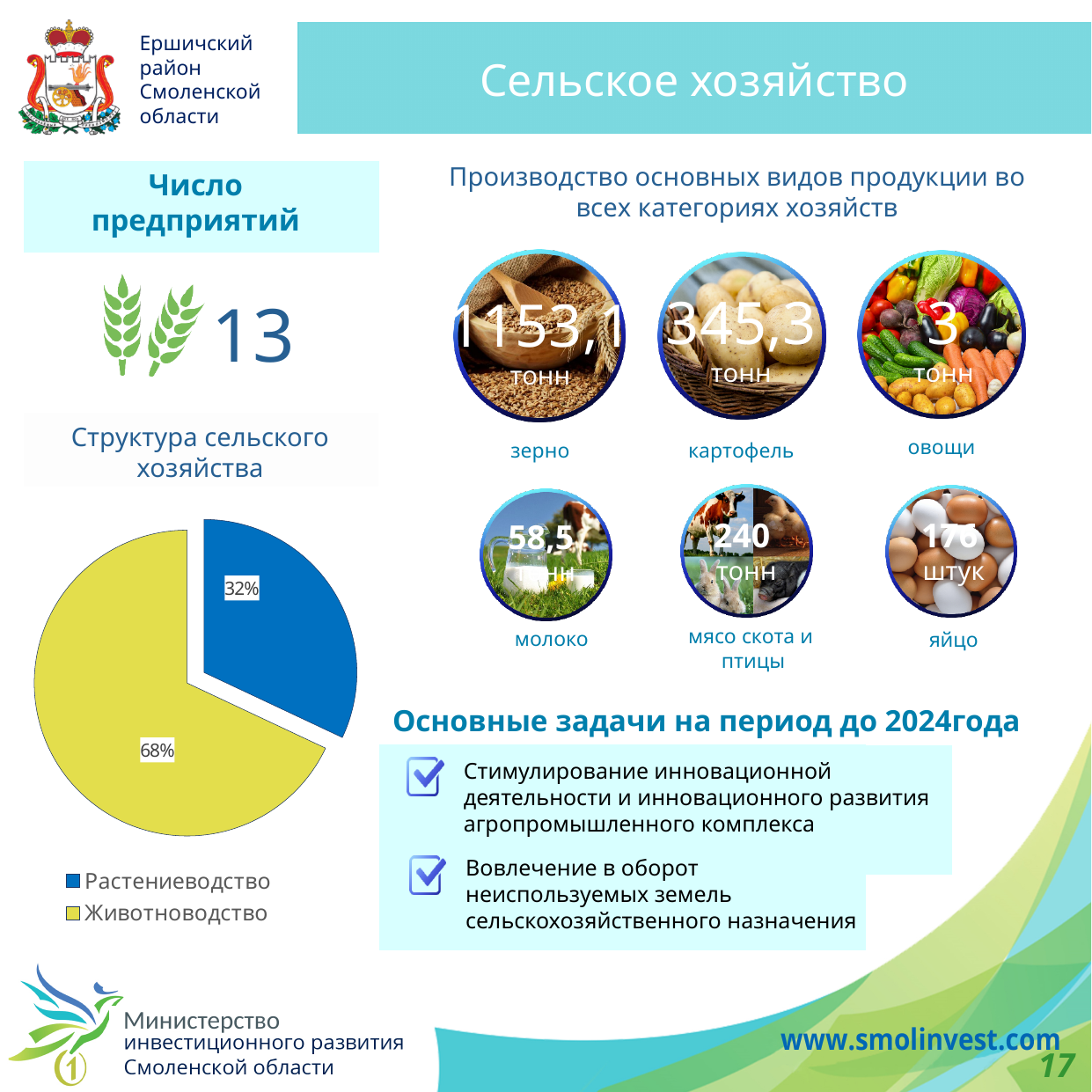
In the pie chart, what share does Животноводство have? 68% Is the share of Растениеводство in the pie chart greater or less than 50%? less What kind of chart is used to show the structure of agriculture (Структура сельского хозяйства)? pie chart Which category has the smallest slice in the pie chart? Растениеводство What colour is the Животноводство slice in the pie chart? yellow By how many percentage points does Животноводство exceed Растениеводство in the pie chart? 36 Which is larger in the pie chart, Растениеводство or Животноводство? Животноводство In the pie chart, what share does Растениеводство have? 32% How many slices does the pie chart have? 2 Which category has the largest slice in the pie chart? Животноводство How many entries does the legend of the pie chart list? 2 What is the title of the pie chart? Структура сельского хозяйства